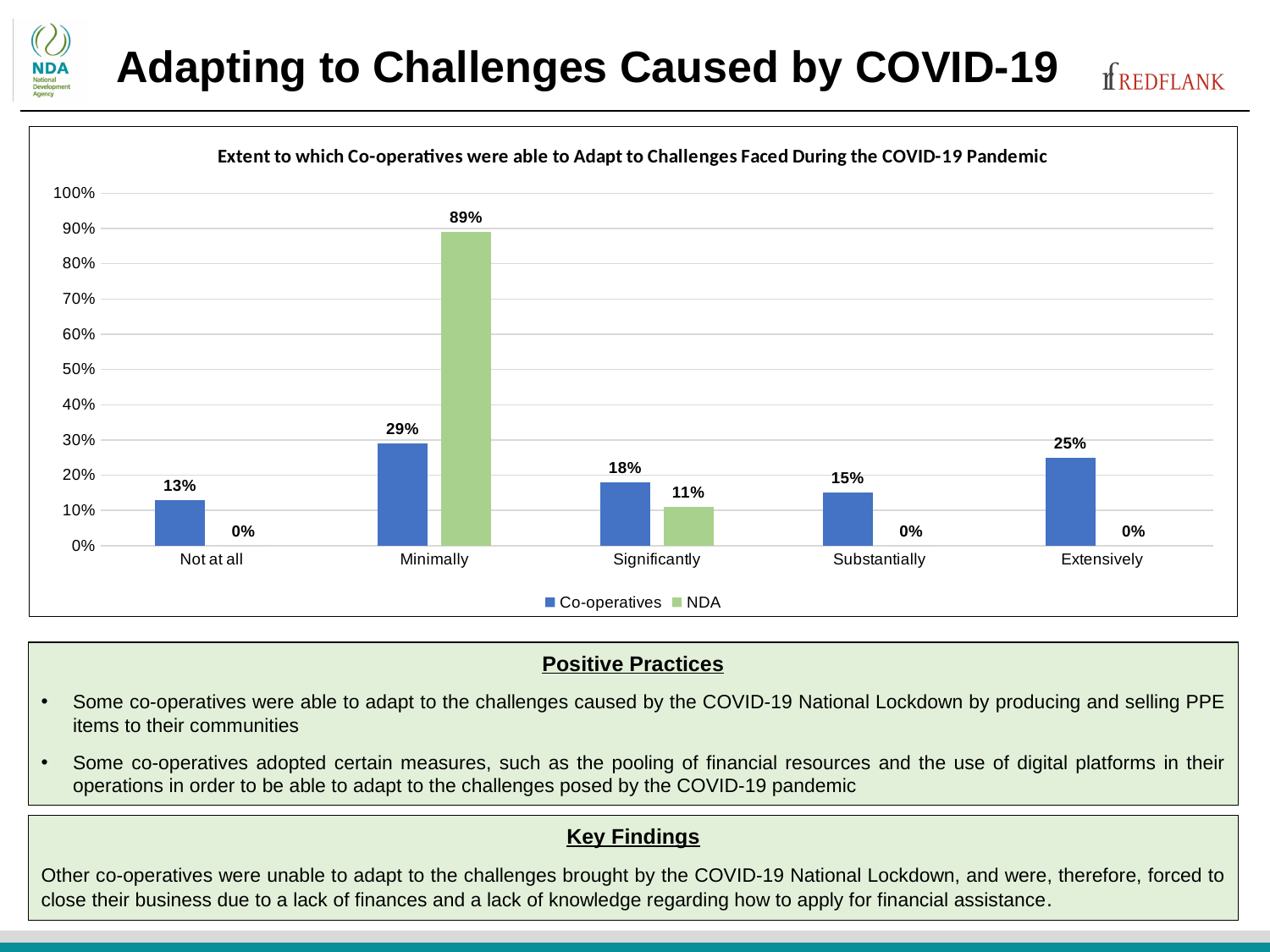
What kind of chart is shown on the slide? Bar chart How many categories are shown on the x axis? 5 What is the difference between the NDA and Co-operatives values for Minimally? 60% What is the NDA value for Not at all? 0% What is the NDA value for Significantly? 11% Which category has the highest NDA value? Minimally Which is larger for Significantly: the Co-operatives value or the NDA value? Co-operatives How many series does the legend list? 2 What is the title of the chart? Extent to which Co-operatives were able to Adapt to Challenges Faced During the COVID-19 Pandemic What is the Co-operatives value for Extensively? 25% Which category has the lowest Co-operatives value? Not at all What is the Co-operatives value for Minimally? 29%